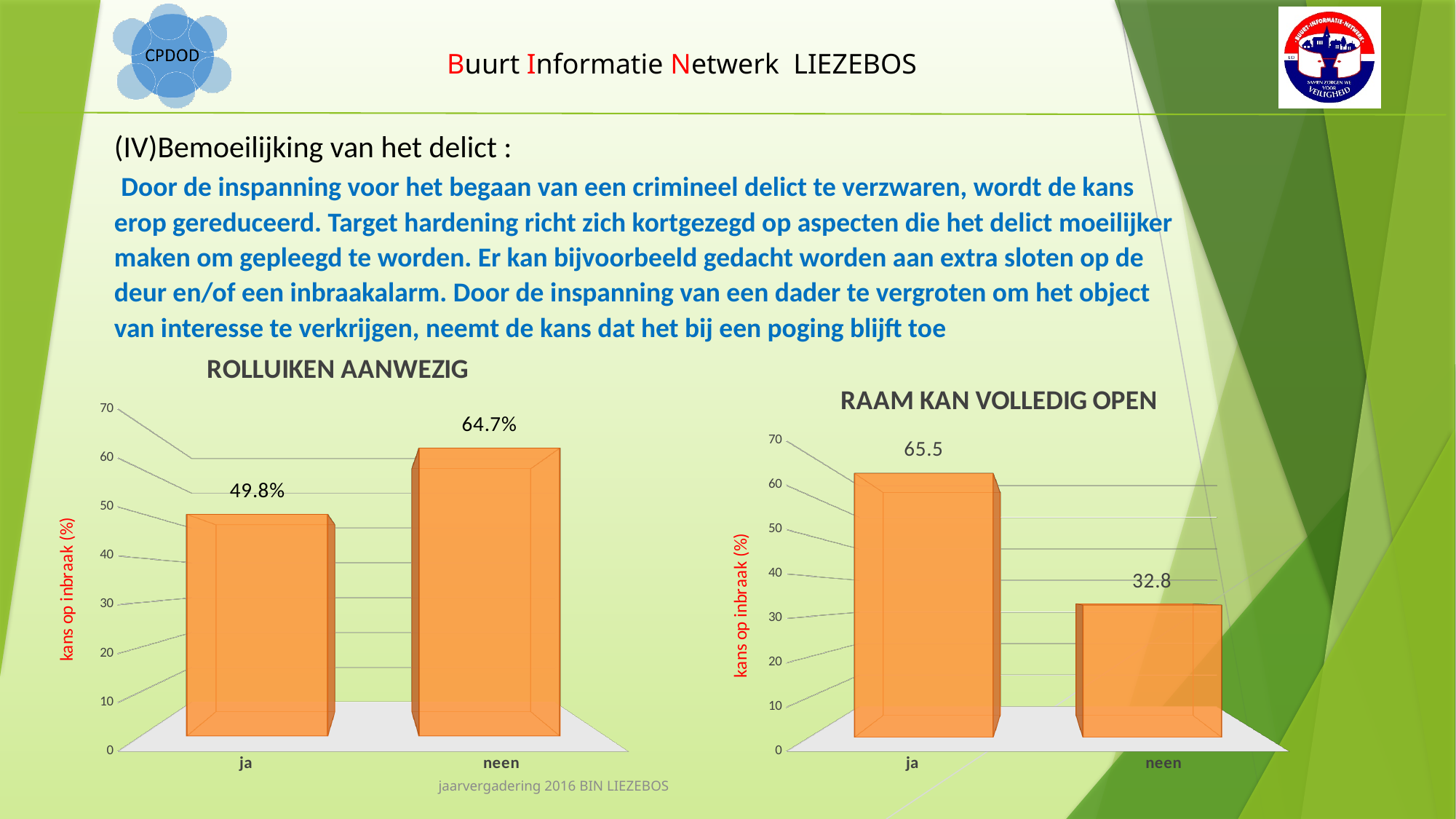
In the 'ROLLUIKEN AANWEZIG' chart, which category has the highest value? neen In the 'ROLLUIKEN AANWEZIG' chart, what is the difference between the values for 'neen' and 'ja'? 14.9% In the 'ROLLUIKEN AANWEZIG' chart, what is the value for 'neen'? 64.7% In the 'RAAM KAN VOLLEDIG OPEN' chart, which is larger, the value for 'ja' or for 'neen'? ja What kind of chart is the 'RAAM KAN VOLLEDIG OPEN' chart? bar chart How many categories are shown in the 'ROLLUIKEN AANWEZIG' chart? 2 In the 'RAAM KAN VOLLEDIG OPEN' chart, what is the value for 'ja'? 65.5 In the 'RAAM KAN VOLLEDIG OPEN' chart, what is the difference between the values for 'ja' and 'neen'? 32.7 What is the y-axis label of the 'ROLLUIKEN AANWEZIG' chart? kans op inbraak (%) In the 'ROLLUIKEN AANWEZIG' chart, what is the value for 'ja'? 49.8% In the 'RAAM KAN VOLLEDIG OPEN' chart, what is the value for 'neen'? 32.8 In the 'RAAM KAN VOLLEDIG OPEN' chart, which category has the lowest value? neen